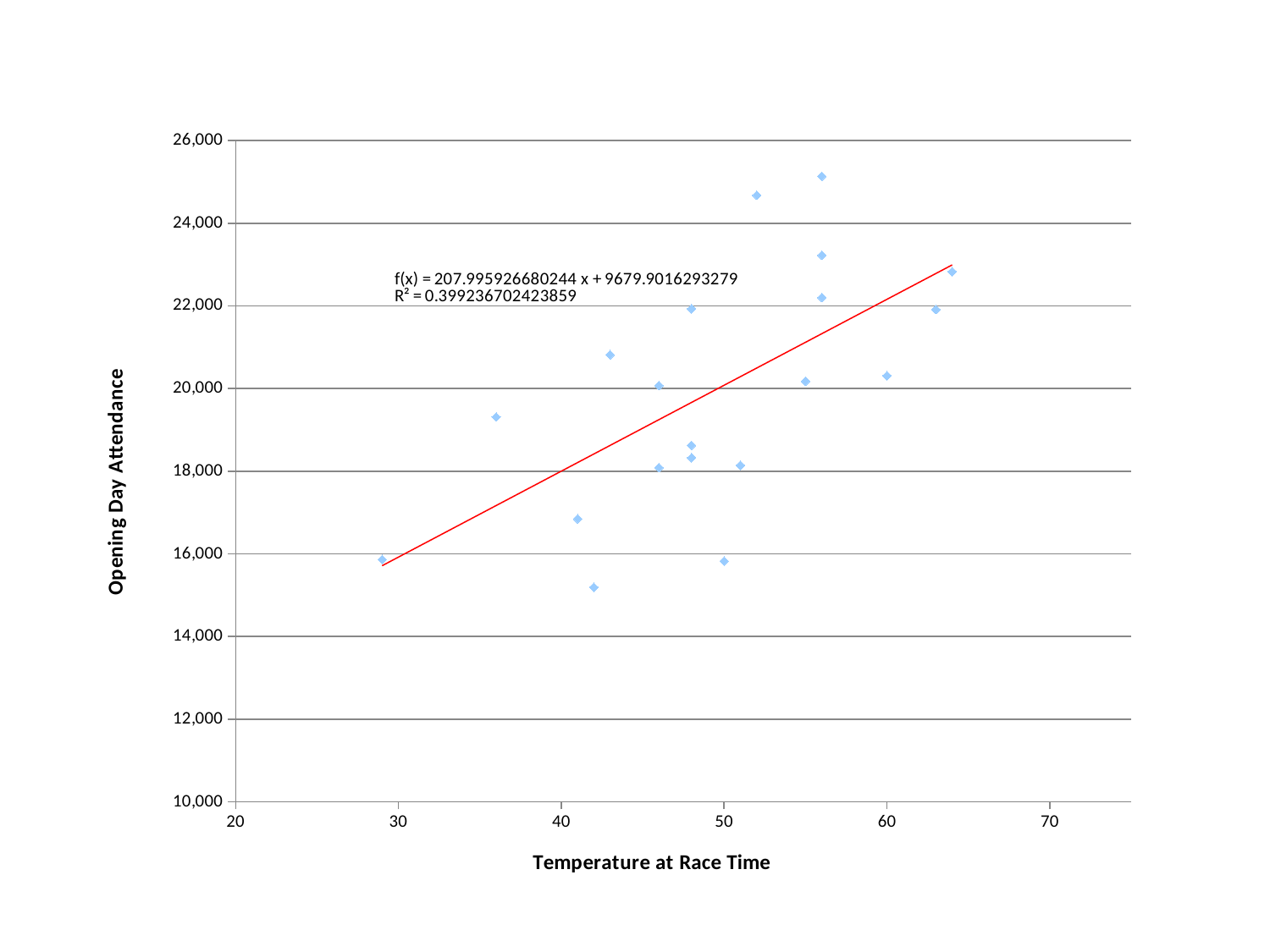
Is the opening day attendance plotted at a temperature of 36 greater or less than 18,000? greater What is the slope of the fitted line f(x) printed on the chart? 207.995926680244 What is the title of the x axis? Temperature at Race Time What is the intercept of the fitted line f(x) printed on the chart? 9679.9016293279 What is the title of the y axis? Opening Day Attendance What kind of chart is shown on the slide? scatter chart Does opening day attendance generally rise or fall as temperature at race time increases, according to the trendline? rise Is the highest plotted opening day attendance greater or less than 24,000? greater Is the opening day attendance plotted at a temperature of 60 greater or less than 22,000? less What R² value is printed on the chart? 0.399236702423859